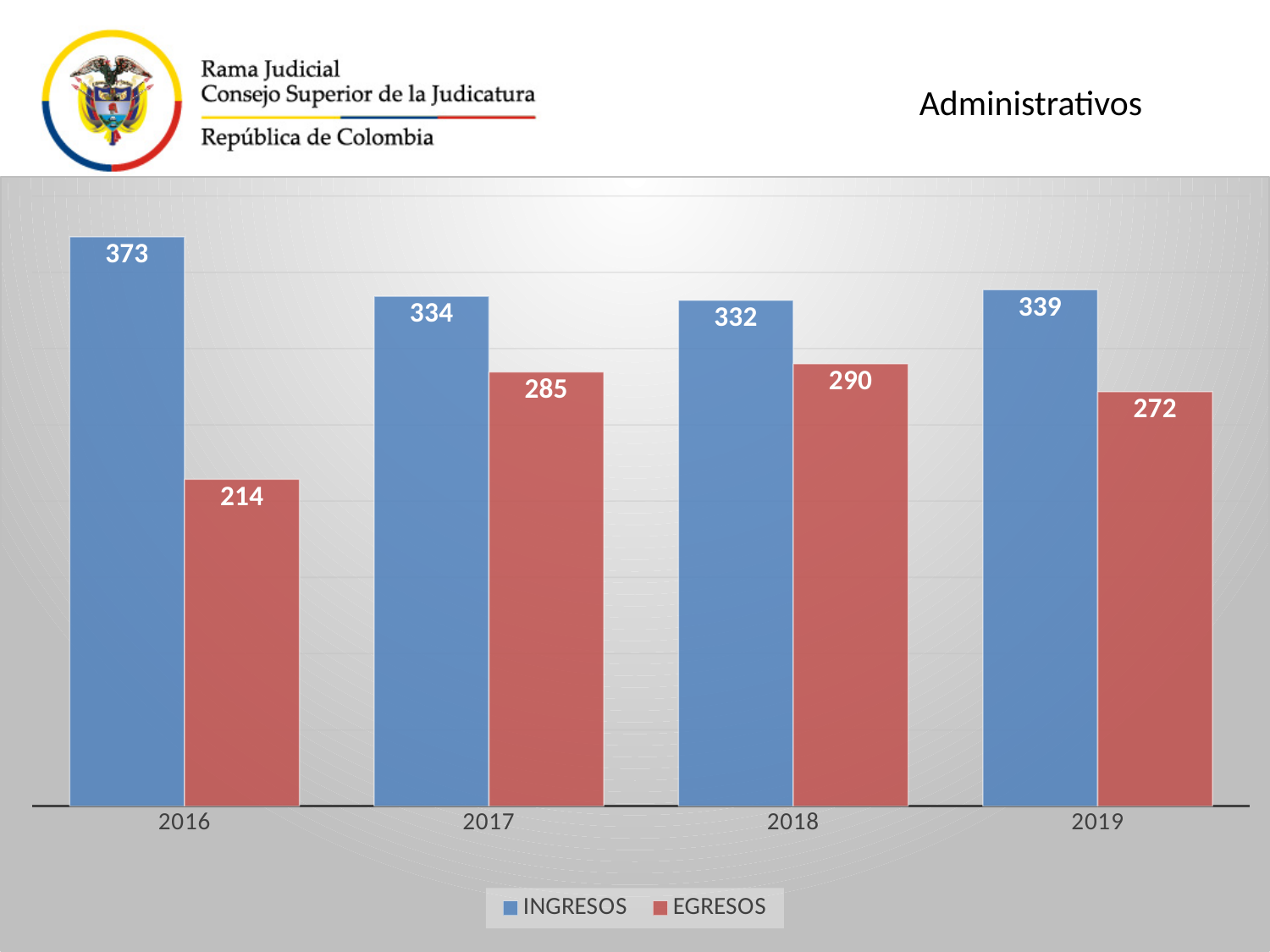
What is the EGRESOS value for 2018? 290 What is the difference between INGRESOS and EGRESOS in 2016? 159 How many series does the legend list? 2 What is the EGRESOS value for 2019? 272 What is the INGRESOS value for 2016? 373 Which year has the lowest EGRESOS value? 2016 What is the difference between INGRESOS and EGRESOS in 2019? 67 Which year has the highest INGRESOS value? 2016 Which series is shown in red in the legend? EGRESOS What kind of chart is shown on the slide? Bar chart How many years are shown on the x axis? 4 Which is larger, EGRESOS in 2017 or EGRESOS in 2019? EGRESOS in 2017